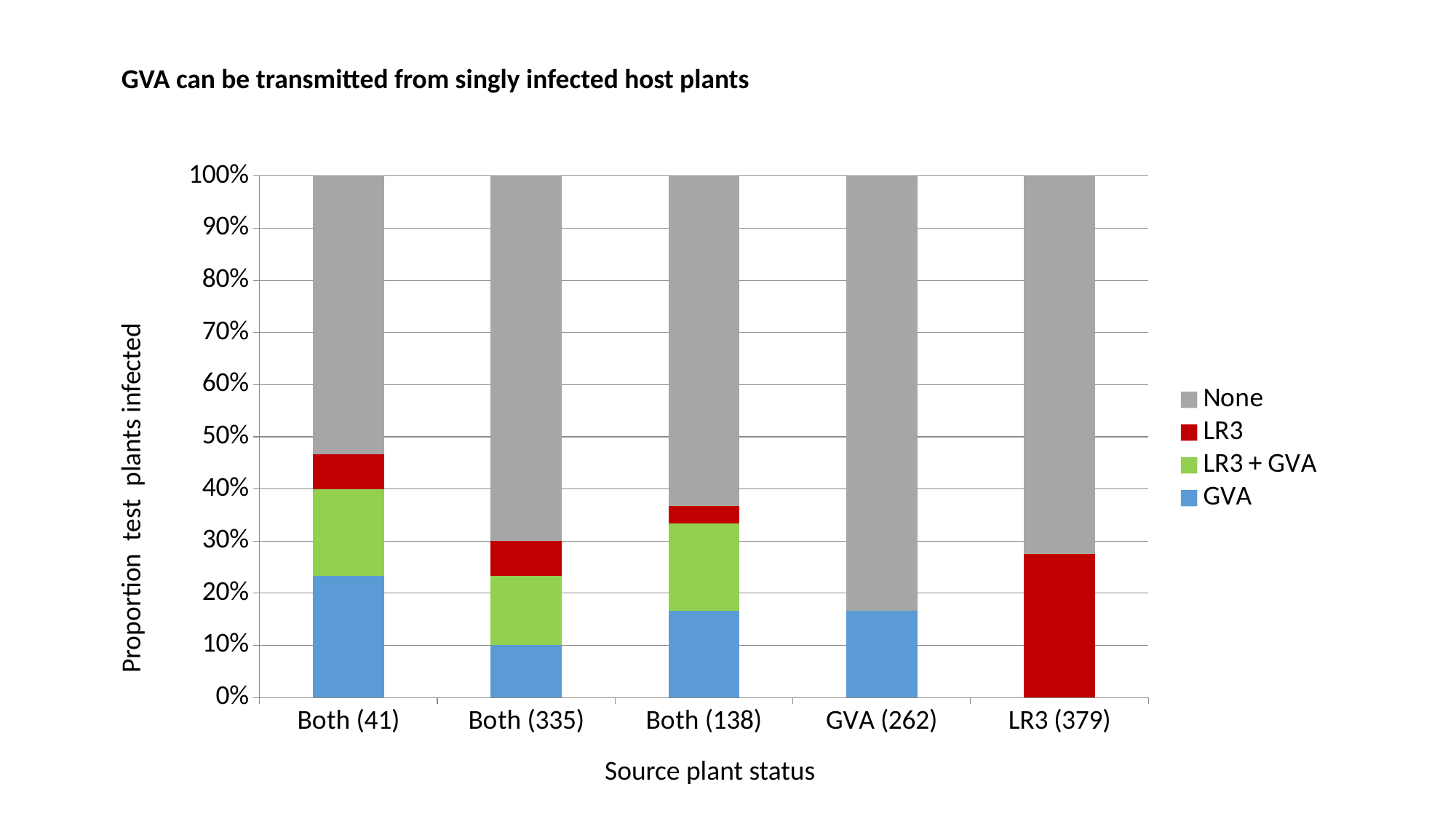
Is the LR3 segment for LR3 (379) greater or less than 20%? greater Which category has the largest GVA segment? Both (41) Is the GVA segment for Both (335) greater or less than 20%? less How many source plant status categories are shown on the x axis? 5 Is the GVA segment for GVA (262) greater or less than 20%? less Which category has the largest None segment? GVA (262) Which has a larger GVA segment, Both (41) or Both (335)? Both (41) How many series does the legend list? 4 What kind of chart is shown on the slide? Stacked bar chart What is the label of the x axis? Source plant status